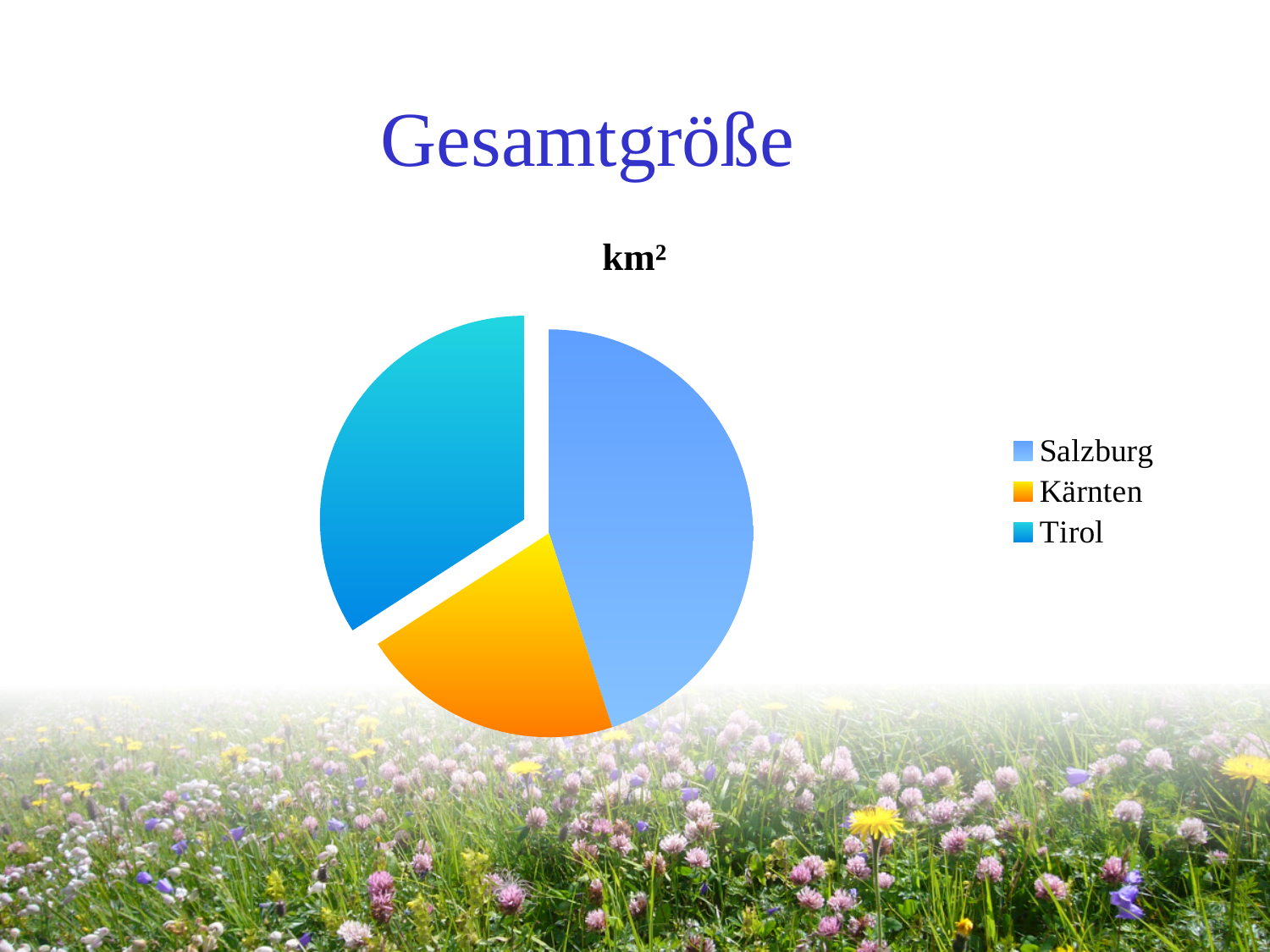
Which category has the largest slice of the pie chart? Salzburg Which slice is larger, Salzburg or Tirol? Salzburg How many entries does the legend list? 3 What is the title of the chart? km² What kind of chart is shown on the slide? pie chart How many slices does the pie chart have? 3 Which slice is larger, Tirol or Kärnten? Tirol Which category has the smallest slice of the pie chart? Kärnten Which category is shown in orange in the pie chart? Kärnten Which slice is smaller, Kärnten or Salzburg? Kärnten